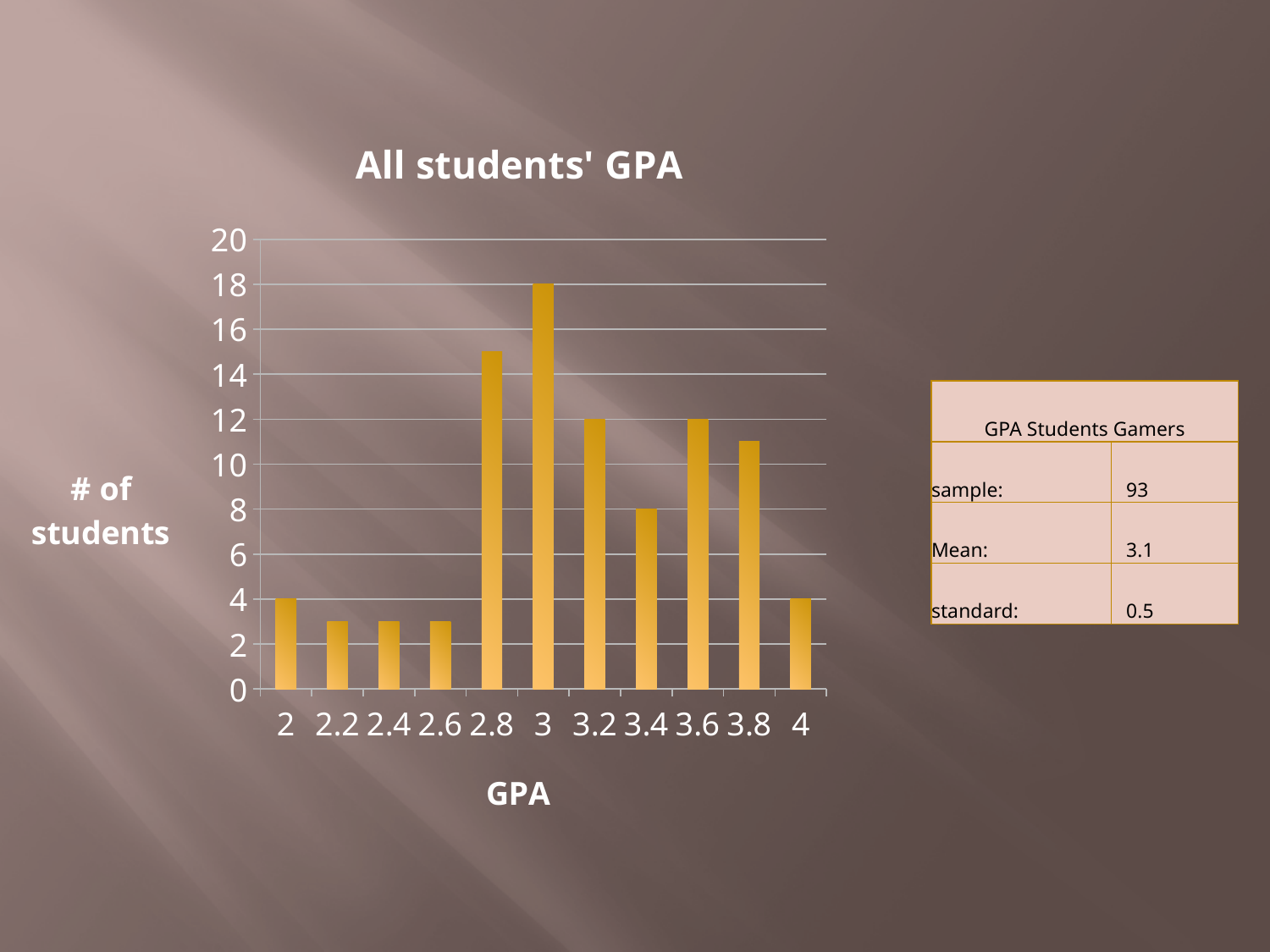
Which has more students: GPA 3.6 or GPA 3.4? 3.6 How many students have a GPA of 3? 18 How many students have a GPA of 4? 4 Is the number of students with a GPA of 2.8 greater or less than 14? greater What is the title of the chart? All students' GPA What is the difference between the number of students with a GPA of 3 and those with a GPA of 3.2? 6 Which GPA category has the highest number of students? 3 Is the number of students with a GPA of 2.2 greater or less than 4? less What kind of chart is shown on the slide? bar chart How many GPA categories are shown on the x axis of the chart? 11 Do the values rise or fall along the x axis from GPA 3 to GPA 3.4? fall How many students have a GPA of 3.4? 8